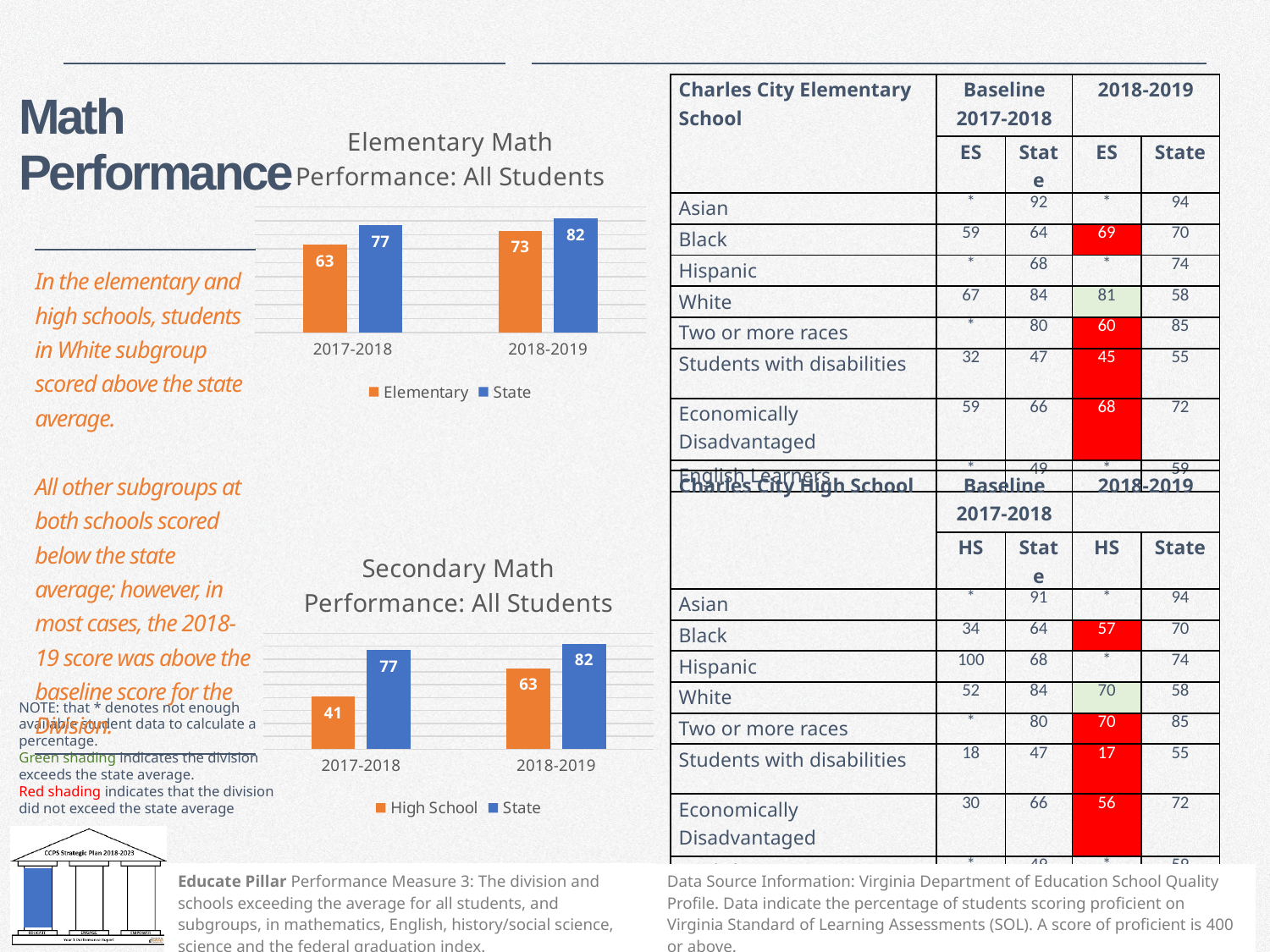
In the Elementary Math Performance: All Students chart, what is the State value for 2018-2019? 82 In the Elementary Math Performance: All Students chart, what is the difference between the State and Elementary values for 2017-2018? 14 In the Elementary Math Performance: All Students chart, does the Elementary value rise or fall from 2017-2018 to 2018-2019? rise What kind of chart is the Secondary Math Performance: All Students chart? bar chart In the Elementary Math Performance: All Students chart, how many series does the legend list? 2 In the Secondary Math Performance: All Students chart, which bar has the lowest value? High School 2017-2018 In the Elementary Math Performance: All Students chart, what is the Elementary value for 2017-2018? 63 In the Secondary Math Performance: All Students chart, which is larger for 2018-2019, High School or State? State In the Secondary Math Performance: All Students chart, what is the High School value for 2017-2018? 41 In the Secondary Math Performance: All Students chart, how many categories are shown on the x axis? 2 In the Secondary Math Performance: All Students chart, what is the difference between the High School values for 2018-2019 and 2017-2018? 22 In the Secondary Math Performance: All Students chart, what is the High School value for 2018-2019? 63